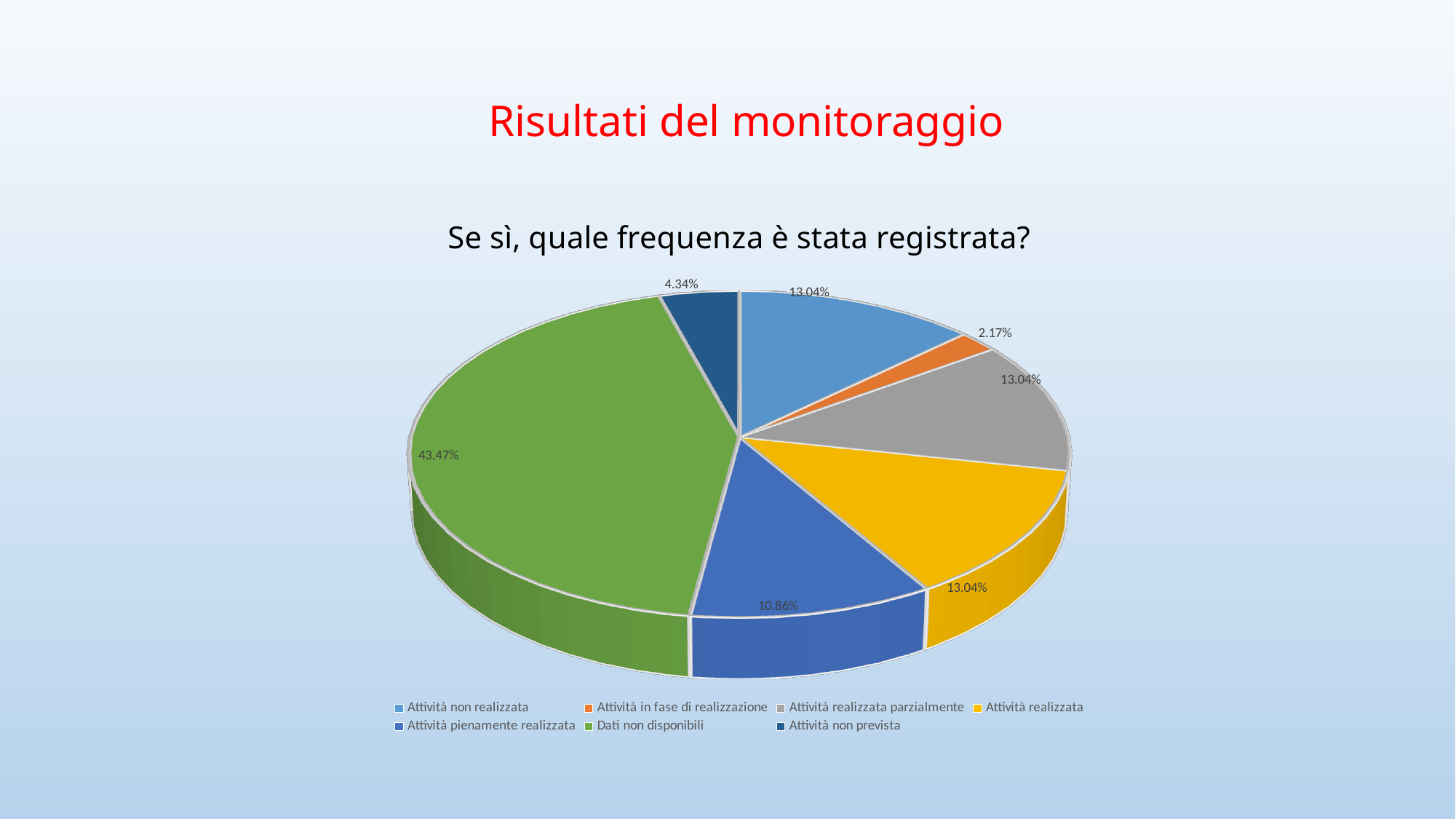
Which category has the smallest slice of the pie? Attività in fase di realizzazione What share of the pie is 'Attività in fase di realizzazione'? 2.17% What is the difference between the share for 'Dati non disponibili' and the share for 'Attività realizzata'? 30.43% What share of the pie is 'Attività non realizzata'? 13.04% Which category has the largest slice of the pie? Dati non disponibili What share of the pie is 'Attività pienamente realizzata'? 10.86% What kind of chart is shown on the slide? pie chart How many slices does the pie chart have? 7 Which is larger, the slice for 'Attività pienamente realizzata' or the slice for 'Attività non prevista'? Attività pienamente realizzata What is the title of the chart? Se sì, quale frequenza è stata registrata?